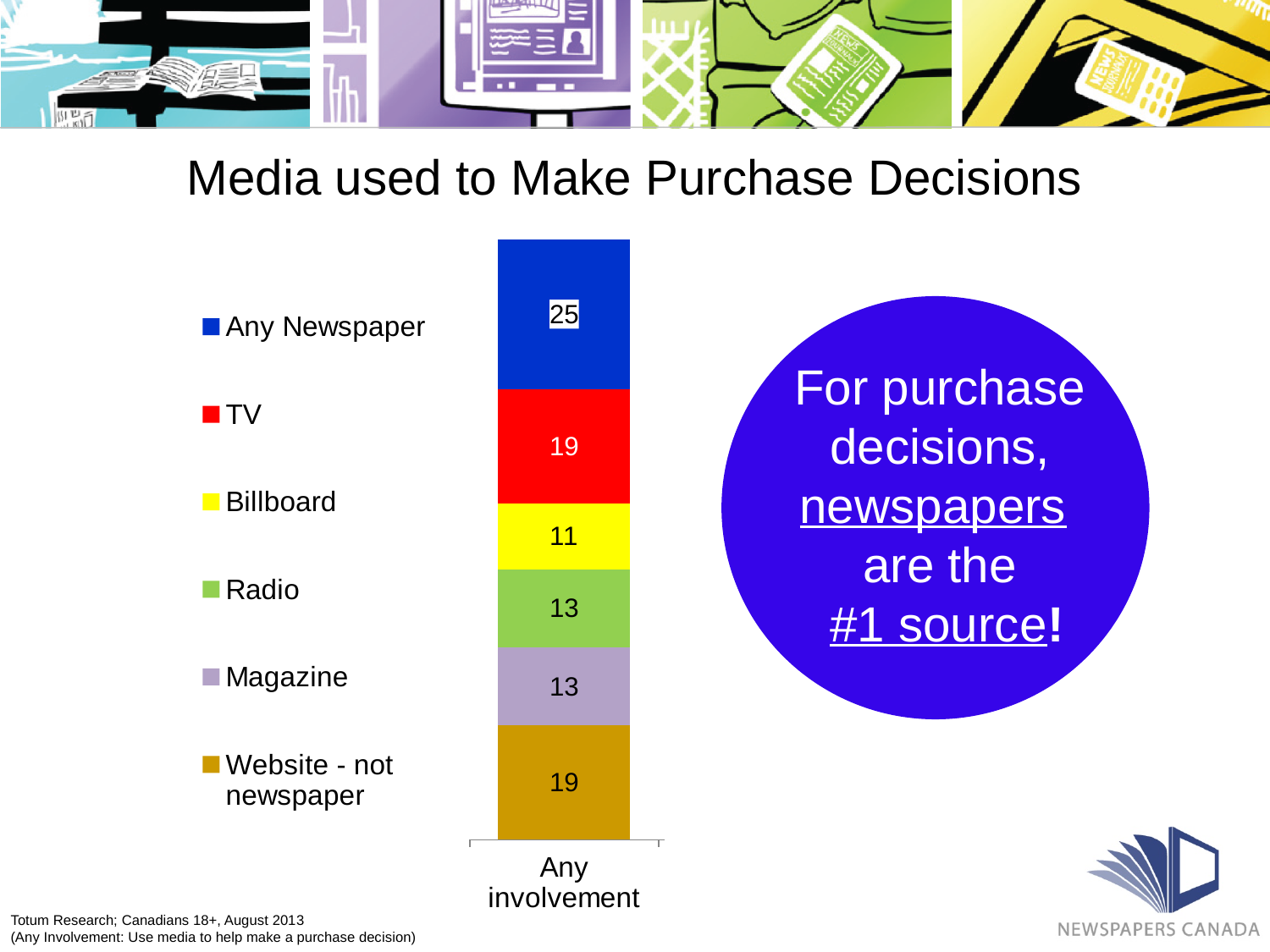
What kind of chart is shown on the slide? Stacked bar chart How many series does the legend list? 6 Which is larger, the value for Radio or the value for Billboard? Radio What is the title of the chart? Media used to Make Purchase Decisions What is the value for Billboard in the stacked bar? 11 What is the value for Any Newspaper in the stacked bar? 25 What is the total of the stacked bar for Any involvement? 100 What is the value for TV in the stacked bar? 19 Which series has the highest value in the stacked bar? Any Newspaper What is the difference between the Any Newspaper value and the TV value? 6 Which series has the lowest value in the stacked bar? Billboard What is the value for Website - not newspaper in the stacked bar? 19